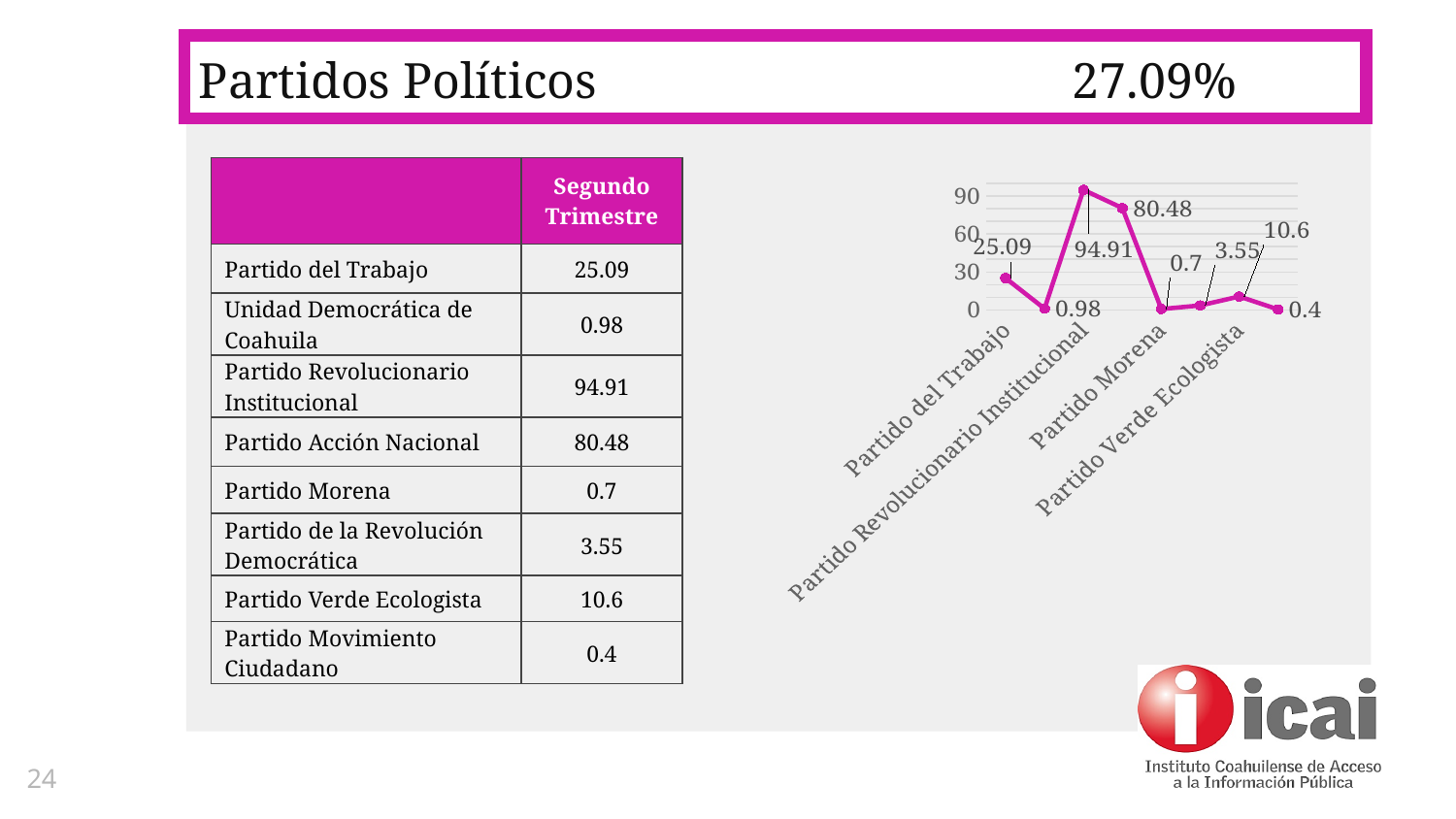
What is the value plotted for Partido Revolucionario Institucional? 94.91 What is the lowest value plotted in the line chart? 0.4 Is the value for Partido Revolucionario Institucional greater or less than 90? greater What is the value plotted for Partido del Trabajo? 25.09 What is the difference between the values for Partido Revolucionario Institucional and Partido del Trabajo? 69.82 Which is larger, the value for Partido del Trabajo or the value for Partido Verde Ecologista? Partido del Trabajo What kind of chart is shown on the slide? line chart How many data points are plotted in the line chart? 8 What is the value plotted for Partido Verde Ecologista? 10.6 Which category has the highest value in the line chart? Partido Revolucionario Institucional What is the value plotted for Partido Morena? 0.7 What is the difference between the values for Partido Verde Ecologista and Partido Morena? 9.9